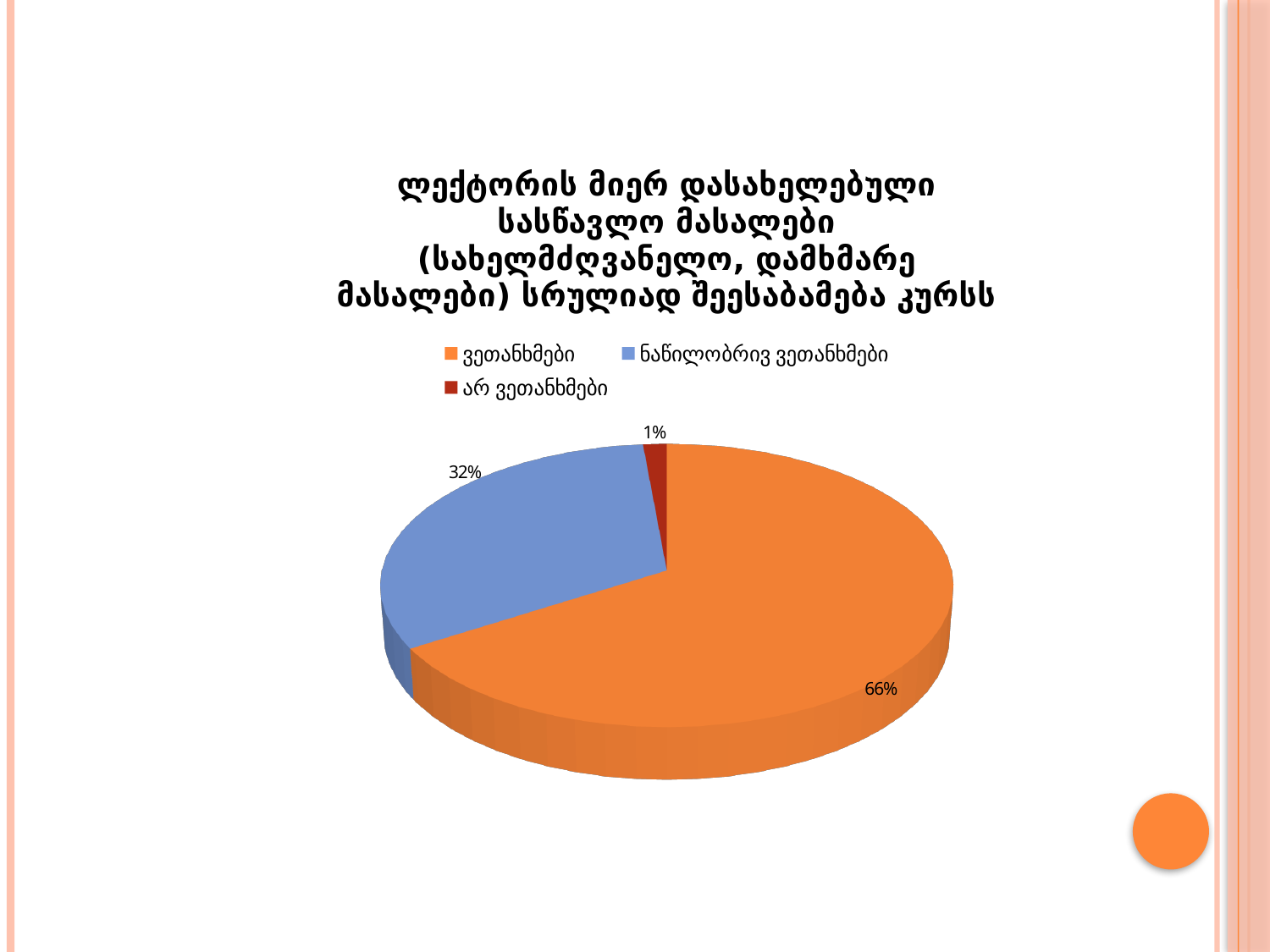
What is the difference between the shares for ვეთანხმები and ნაწილობრივ ვეთანხმები? 34% How many entries does the legend list? 3 What percentage is shown for ვეთანხმები? 66% What colour is the slice for ვეთანხმები? orange Which is larger, the share for ნაწილობრივ ვეთანხმები or the share for არ ვეთანხმები? ნაწილობრივ ვეთანხმები What kind of chart is shown on the slide? pie chart What percentage is shown for ნაწილობრივ ვეთანხმები? 32% Which category has the largest share of the pie? ვეთანხმები Which category has the smallest share of the pie? არ ვეთანხმები What percentage is shown for არ ვეთანხმები? 1% How many categories does the pie chart have? 3 What colour is the slice for ნაწილობრივ ვეთანხმები? blue